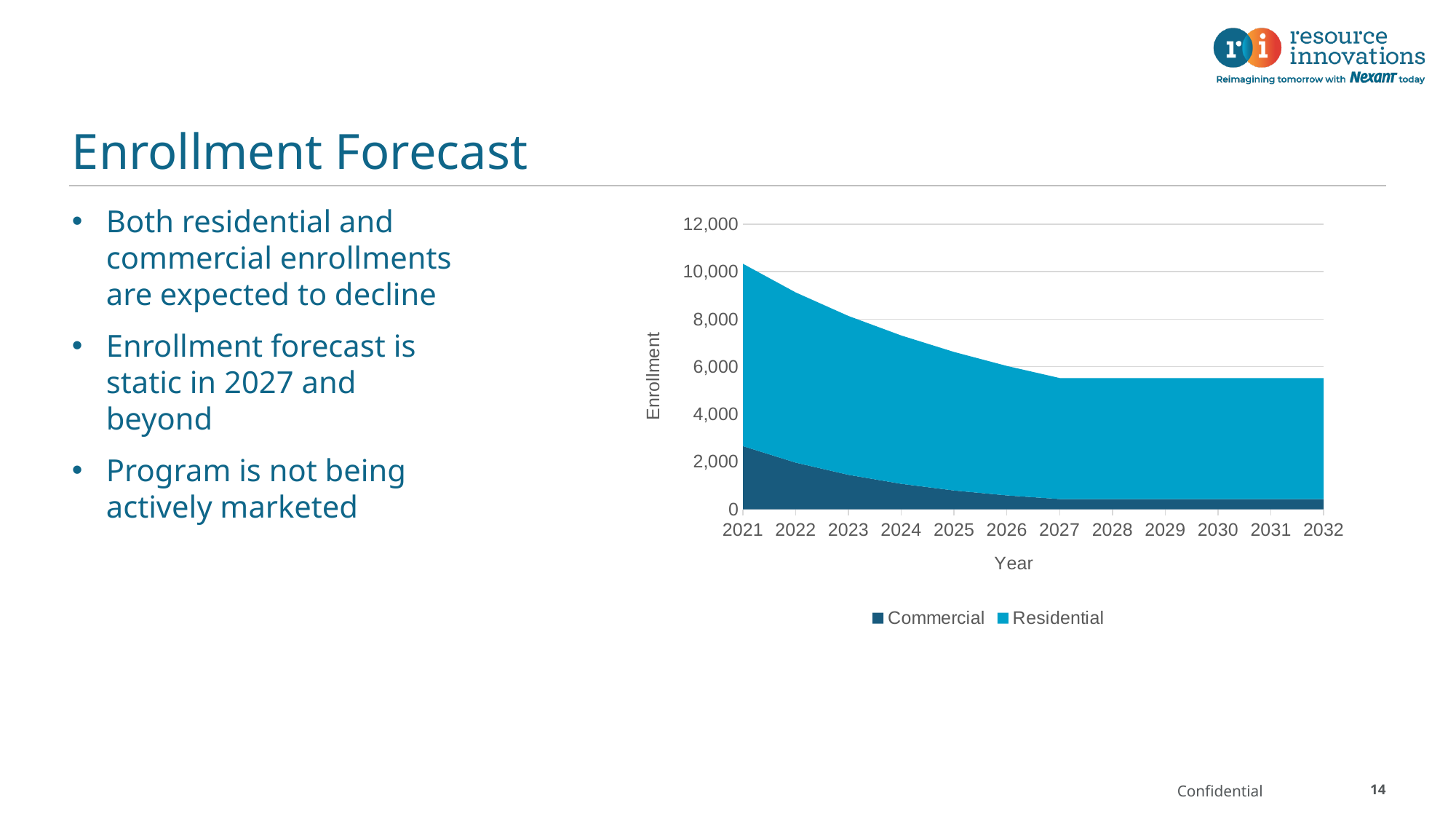
What is the label on the y axis of the chart? Enrollment Which series is shown in the darker blue colour in the chart? Commercial Is the Commercial enrollment in 2021 greater or less than 2,000? greater Is the Commercial enrollment in 2032 greater or less than 1,000? less Is the total enrollment in 2032 greater or less than 6,000? less How many series does the chart legend list? 2 How does total enrollment change from 2021 to 2027 in the chart? It falls How many years are shown along the x axis of the chart? 12 Which year has the highest total enrollment in the chart? 2021 What kind of chart is shown on the slide? Stacked area chart Which year has the larger total enrollment, 2021 or 2025? 2021